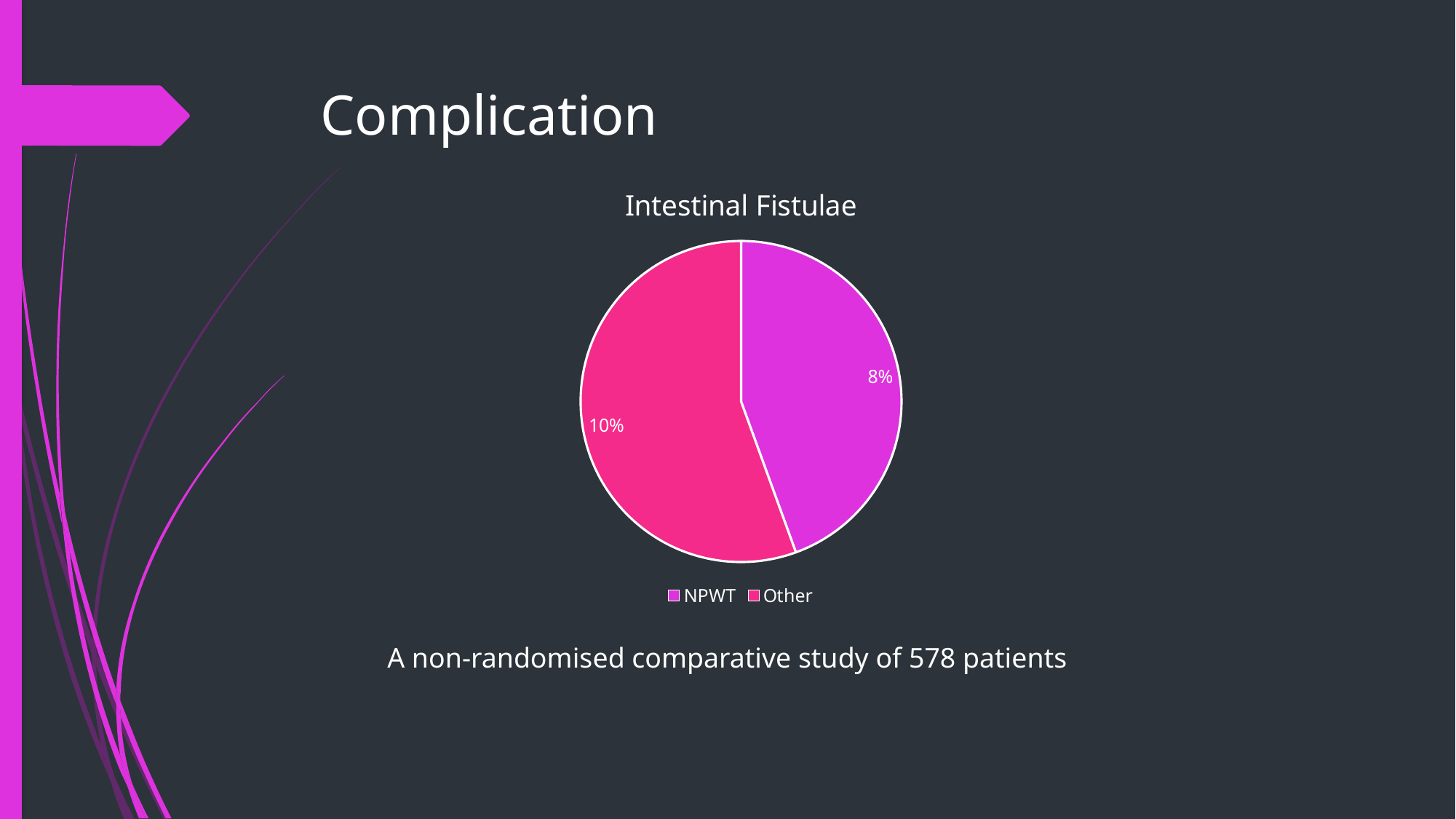
What value is labelled on the Other slice of the pie chart? 10% How many entries does the legend of the pie chart list? 2 What is the difference between the labelled values for Other and NPWT? 2% What kind of chart is shown on the slide? pie chart What is the title of the pie chart? Intestinal Fistulae Which slice of the pie chart has the smaller labelled value? NPWT Is the labelled value for Other larger or smaller than the labelled value for NPWT? larger What value is labelled on the NPWT slice of the pie chart? 8% Which legend entry is shown in pink (the second colour) in the pie chart? Other How many slices does the pie chart have? 2 Which slice of the pie chart has the larger labelled value? Other